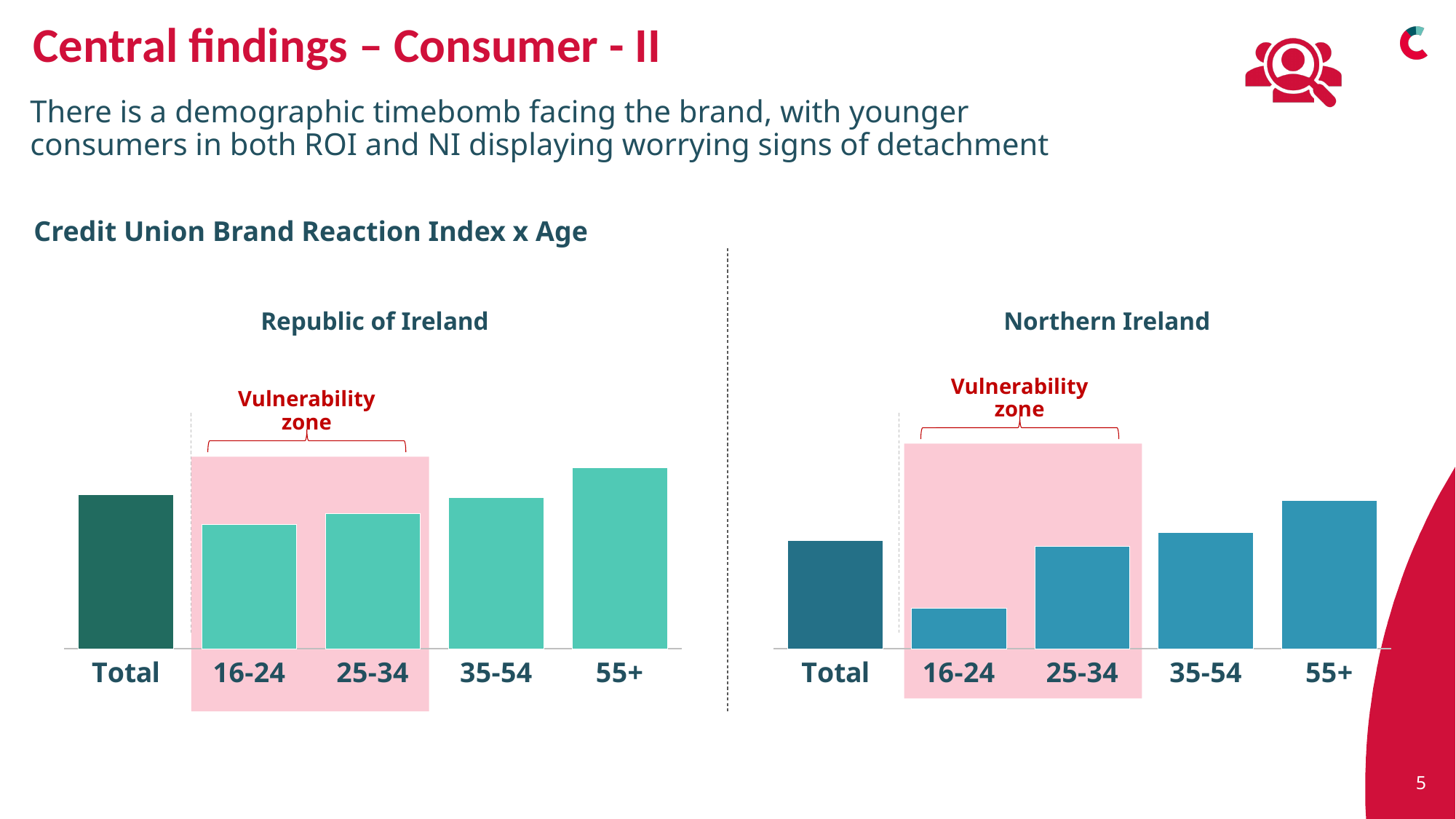
In the Northern Ireland chart, which age group has the highest bar? 55+ In the Northern Ireland chart, do the bars rise or fall moving from the 16-24 group to the 55+ group? Rise What kind of chart is used for the Republic of Ireland panel? Bar chart How many bars are shown in the Northern Ireland chart? 5 What is the title of the chart section on the slide? Credit Union Brand Reaction Index x Age In the Northern Ireland chart, which category has the lowest bar? 16-24 In the Republic of Ireland chart, which age group has the highest bar? 55+ In the Republic of Ireland chart, which is larger, the bar for 16-24 or the bar for 55+? 55+ In the Northern Ireland chart, which is larger, the bar for 16-24 or the bar for 35-54? 35-54 How many categories are shown on the x axis of the Republic of Ireland chart? 5 Which age groups are highlighted as the "Vulnerability zone" in both charts? 16-24 and 25-34 In the Republic of Ireland chart, which is larger, the bar for Total or the bar for 16-24? Total